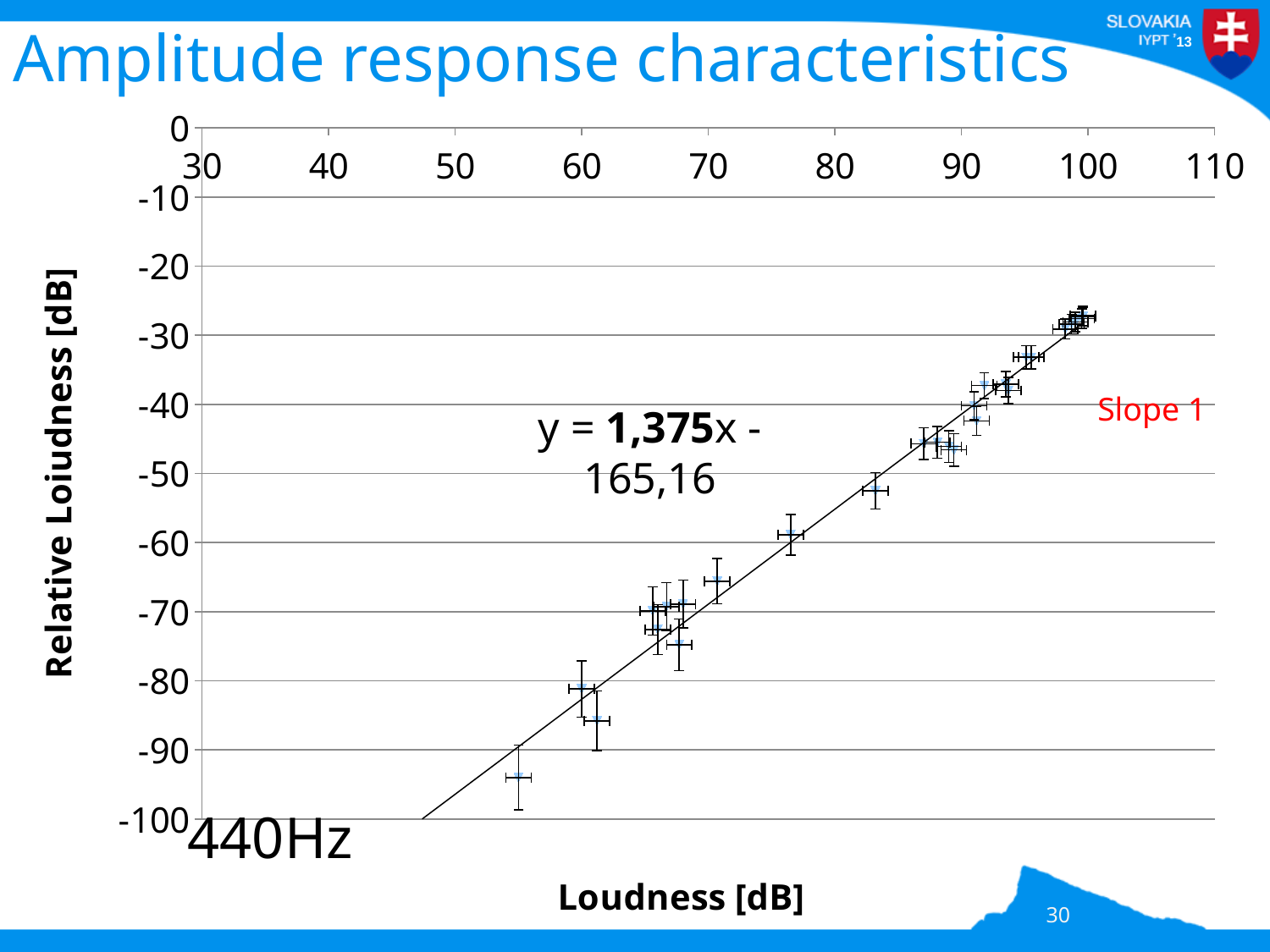
Is the relative loudness of the data points near 100 dB loudness greater or less than -30? greater What is the intercept of the fitted line shown in the equation on the chart? -165,16 Does relative loudness rise or fall as loudness increases along the x axis? rise Is the relative loudness of the data point near 83 dB loudness greater or less than -60? greater What is the slope of the fitted line shown in the equation on the chart? 1,375 What is the highest value shown on the x axis? 110 What is the full trendline equation printed on the chart? y = 1,375x - 165,16 What kind of chart is shown on the slide? scatter plot What frequency is annotated at the bottom left of the chart? 440Hz Is the relative loudness of the data point near 61 dB loudness greater or less than -80? less What is the label of the x axis? Loudness [dB]